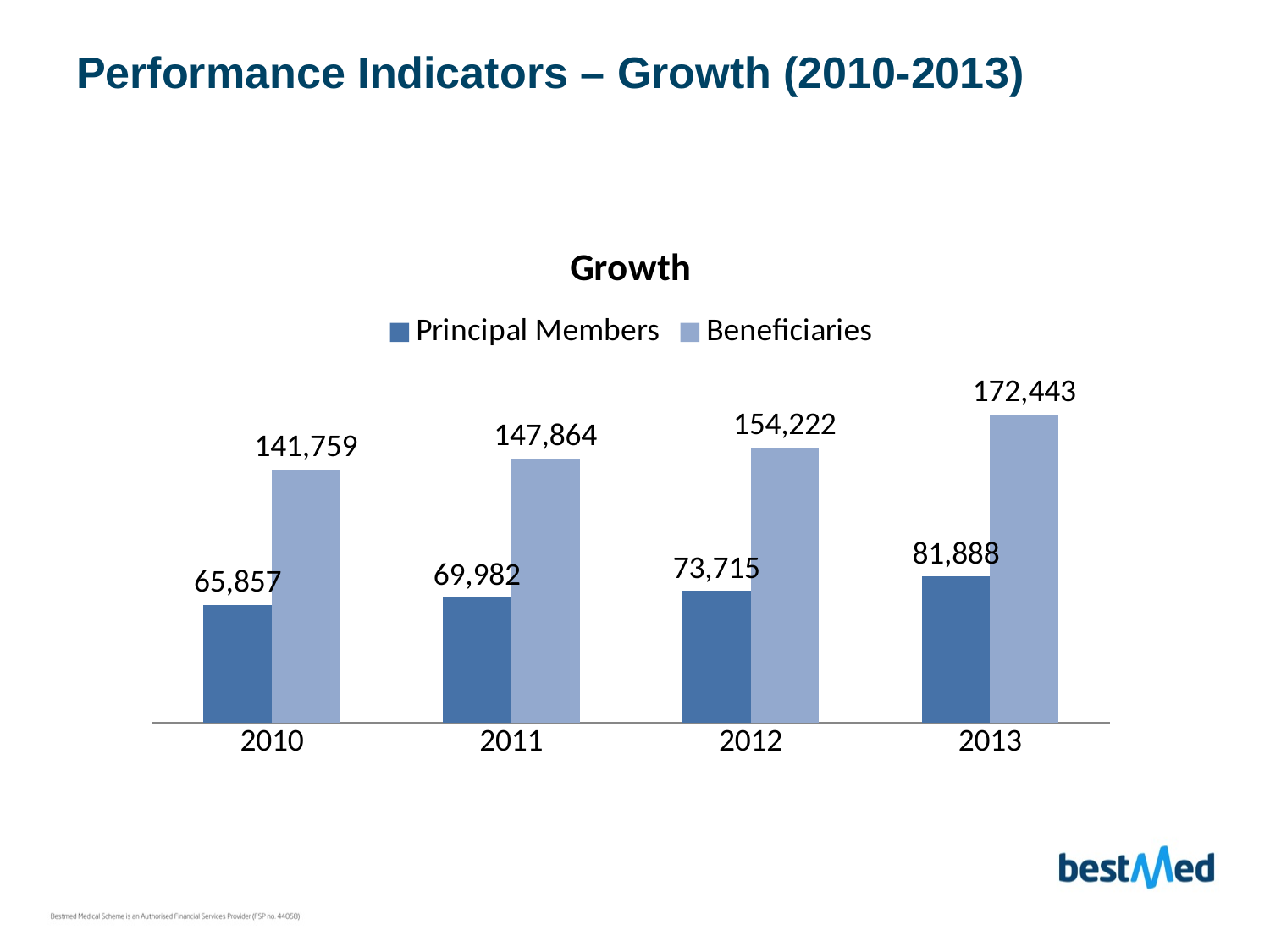
In which year is the number of Beneficiaries highest? 2013 In which year is the number of Principal Members lowest? 2010 What is the number of Beneficiaries in 2013? 172,443 What is the number of Principal Members in 2012? 73,715 By how much did the number of Principal Members increase from 2010 to 2013? 16,031 How many years are shown on the x axis? 4 What kind of chart is shown on the slide? Bar chart How many series does the legend list? 2 What is the number of Beneficiaries in 2011? 147,864 What is the difference between Beneficiaries and Principal Members in 2013? 90,555 Which is larger in 2012: Principal Members or Beneficiaries? Beneficiaries What is the number of Principal Members in 2010? 65,857